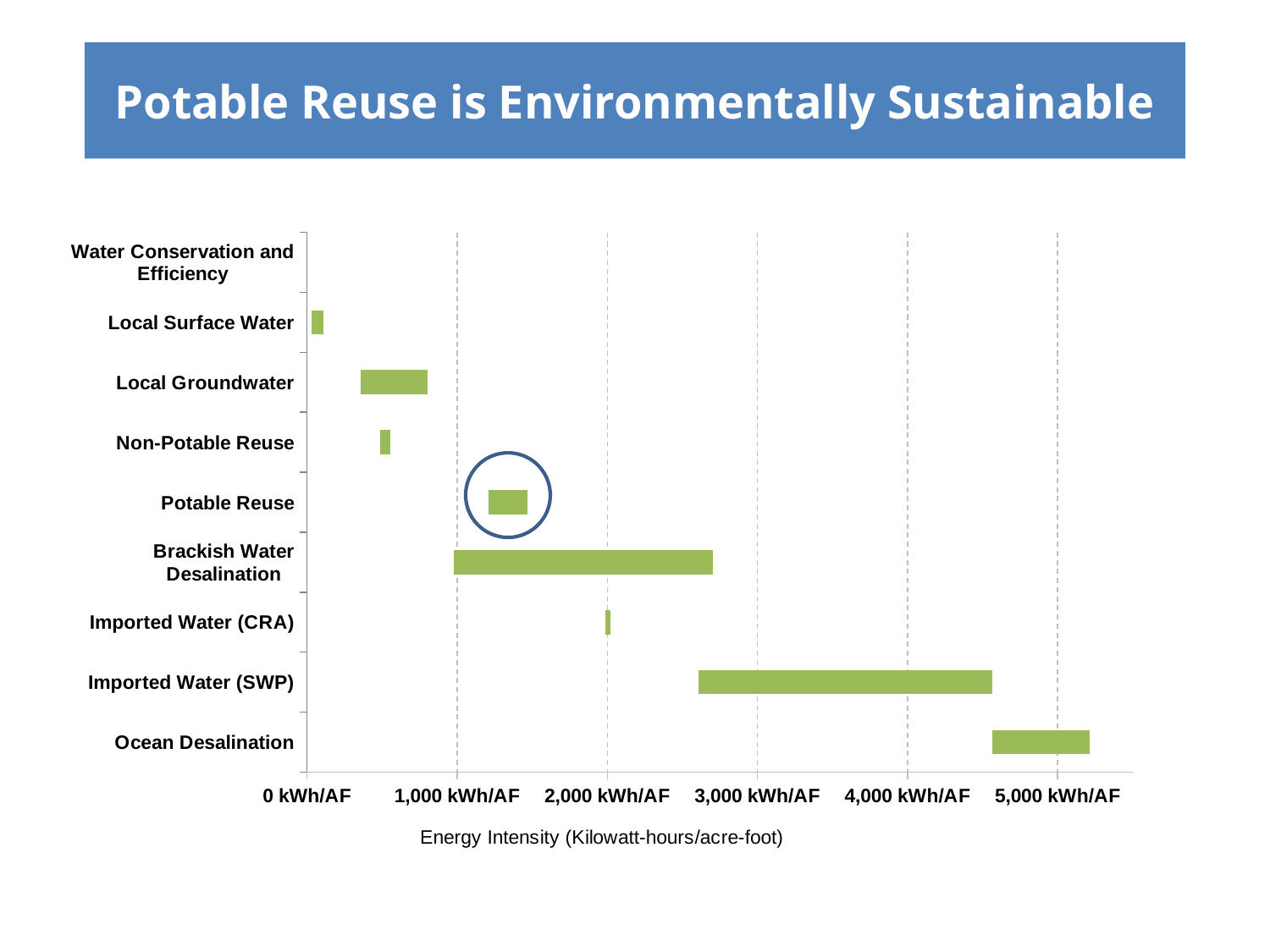
Which has a higher energy intensity, Imported Water (SWP) or Potable Reuse? Imported Water (SWP) What kind of chart is shown on the slide? Bar chart Is the energy intensity for Potable Reuse greater or less than 1,000 kWh/AF? greater Which category's bar is highlighted with a circle on the chart? Potable Reuse How many water supply categories are listed on the vertical axis of the chart? 9 Is the upper end of the Imported Water (SWP) bar greater or less than 5,000 kWh/AF? less Is the upper end of the Brackish Water Desalination bar greater or less than 3,000 kWh/AF? less Which category with a visible bar has the lowest energy intensity on the chart? Local Surface Water What is the label of the horizontal axis of the chart? Energy Intensity (Kilowatt-hours/acre-foot) Which category has the highest energy intensity on the chart? Ocean Desalination